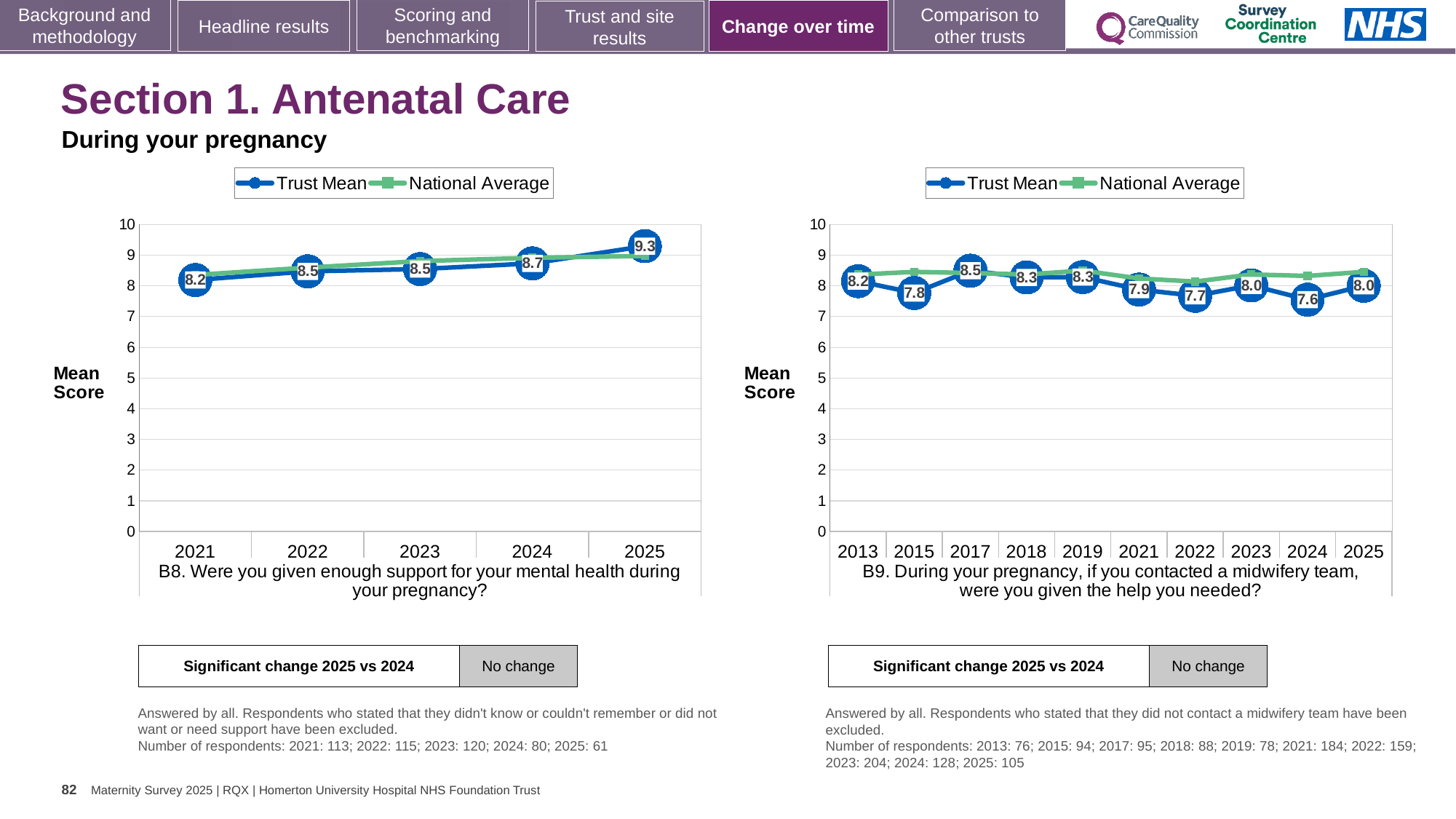
In the B8 chart (left), how many years are shown on the x axis? 5 How many series does the legend of the B9 chart (right) list? 2 In the B8 chart (left), what is the difference between the Trust Mean in 2025 and in 2024? 0.6 In the B9 chart (right), which year has the lowest Trust Mean? 2024 In the B9 chart (right), what is the Trust Mean for 2024? 7.6 In the B9 chart (right), how many years are shown on the x axis? 10 In the B8 chart (left), does the Trust Mean rise or fall from 2021 to 2025? rise In the B9 chart (right), is the Trust Mean for 2015 larger or smaller than the Trust Mean for 2017? smaller In the B8 chart (left), what is the Trust Mean for 2025? 9.3 In the B9 chart (right), which year has the highest Trust Mean? 2017 In the B8 chart (left), which year has the highest Trust Mean? 2025 In the B8 chart (left), what is the Trust Mean for 2021? 8.2